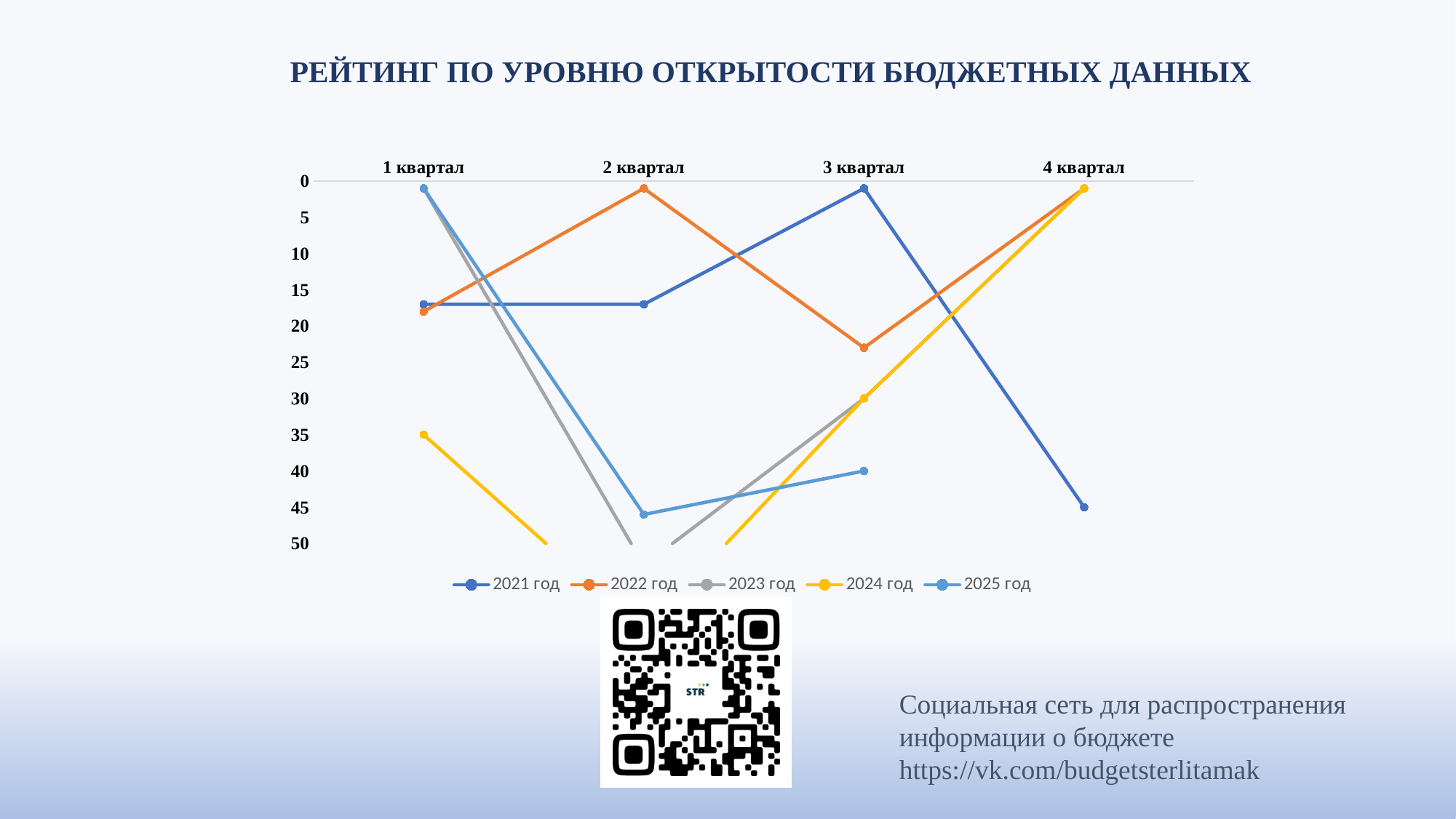
What is the title of the chart? РЕЙТИНГ ПО УРОВНЮ ОТКРЫТОСТИ БЮДЖЕТНЫХ ДАННЫХ How many series does the legend list? 5 Is the value for 2021 год in 4 квартал greater or less than 40? greater Does the value for 2022 год rise or fall from 3 квартал to 4 квартал? fall How many quarters (categories) are shown on the x axis? 4 Is the value for 2025 год in 3 квартал greater or less than 35? greater What kind of chart is shown on the slide? line chart Which is larger in 4 квартал: the value for 2021 год or the value for 2022 год? 2021 год Is the value for 2021 год in 3 квартал greater or less than 5? less Which series has the largest value in 4 квартал? 2021 год